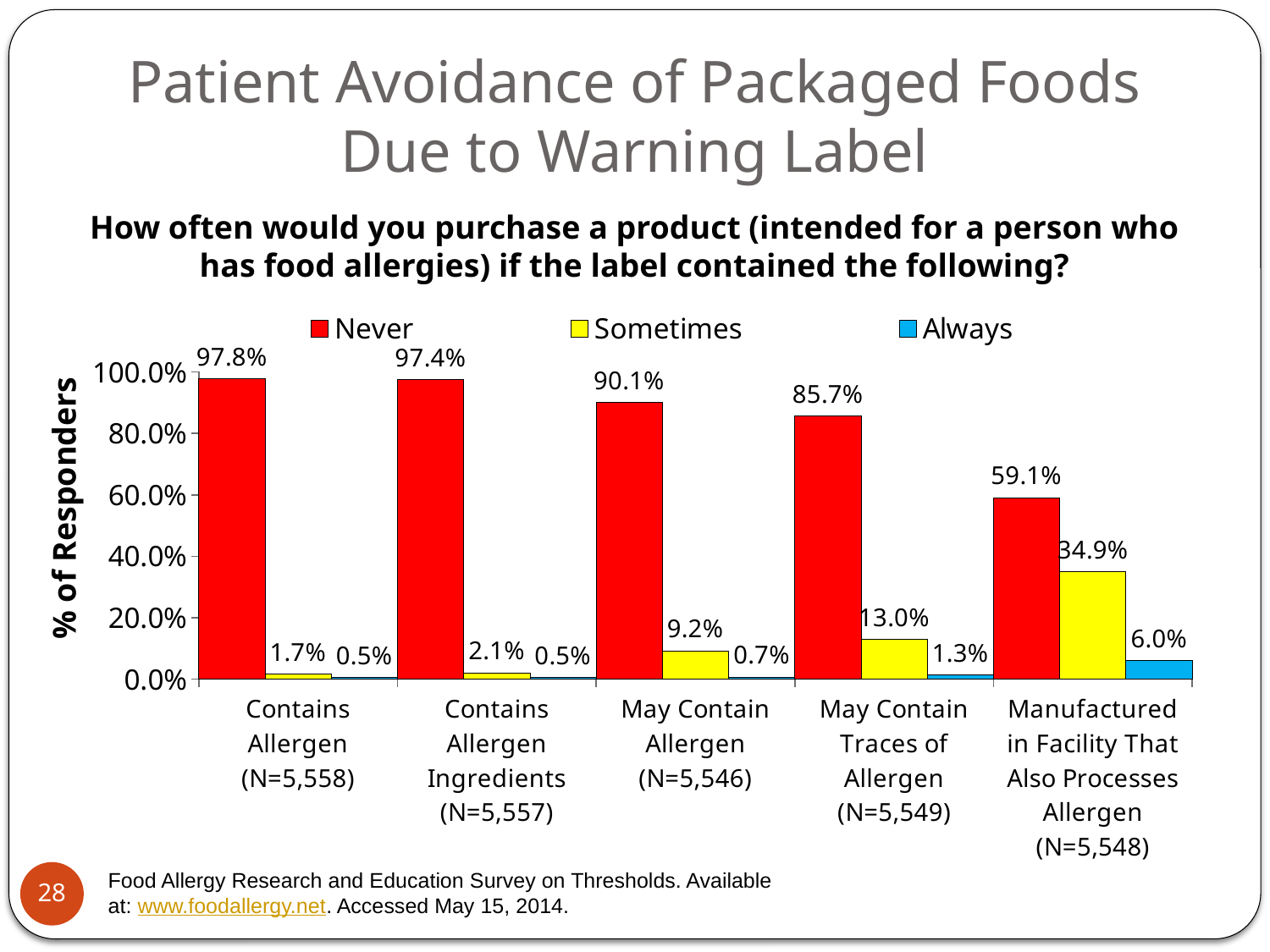
What kind of chart is shown on the slide? Bar chart Which label category has the lowest Never percentage? Manufactured in Facility That Also Processes Allergen Is the Never value for "May Contain Traces of Allergen" greater or less than 80.0%? greater What is the Always value for "May Contain Traces of Allergen"? 1.3% What is the difference between the Never values for "Contains Allergen" and "May Contain Allergen"? 7.7% What is the y-axis label of the chart? % of Responders What percentage of responders said they would Never purchase a product labeled "Contains Allergen"? 97.8% Which is larger: the Sometimes value for "May Contain Allergen" or the Sometimes value for "May Contain Traces of Allergen"? May Contain Traces of Allergen What is the Sometimes value for "Manufactured in Facility That Also Processes Allergen"? 34.9% Which label category has the highest Always percentage? Manufactured in Facility That Also Processes Allergen How many series does the legend list? 3 How many label categories are shown on the x axis? 5